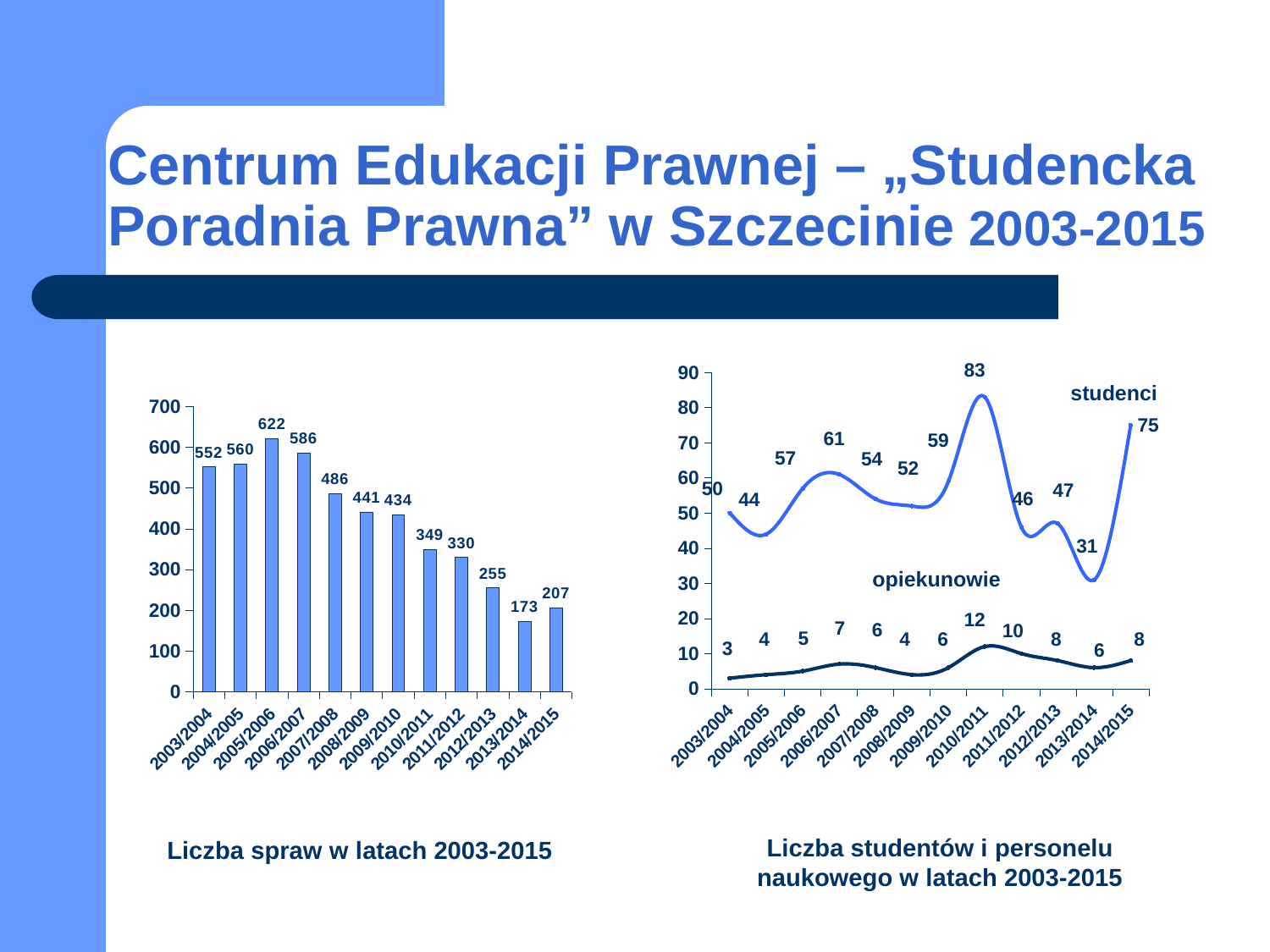
In the left chart (Liczba spraw w latach 2003-2015), what is the value for 2005/2006? 622 In the right chart (Liczba studentów i personelu naukowego), what is the value for studenci in 2010/2011? 83 In the left chart (Liczba spraw w latach 2003-2015), how many years are shown on the x axis? 12 What kind of chart is the right chart (Liczba studentów i personelu naukowego)? line chart In the right chart (Liczba studentów i personelu naukowego), in which year is the studenci value lowest? 2013/2014 In the left chart (Liczba spraw w latach 2003-2015), which year has the lowest number of cases? 2013/2014 In the left chart (Liczba spraw w latach 2003-2015), do the values generally rise or fall from 2005/2006 to 2013/2014? fall In the right chart (Liczba studentów i personelu naukowego), what is the value for opiekunowie in 2011/2012? 10 In the right chart (Liczba studentów i personelu naukowego), which is larger: the studenci value in 2014/2015 or in 2012/2013? 2014/2015 What kind of chart is the left chart (Liczba spraw w latach 2003-2015)? bar chart In the right chart (Liczba studentów i personelu naukowego), what is the difference between the studenci and opiekunowie values in 2010/2011? 71 In the left chart (Liczba spraw w latach 2003-2015), what is the difference between the values for 2003/2004 and 2014/2015? 345